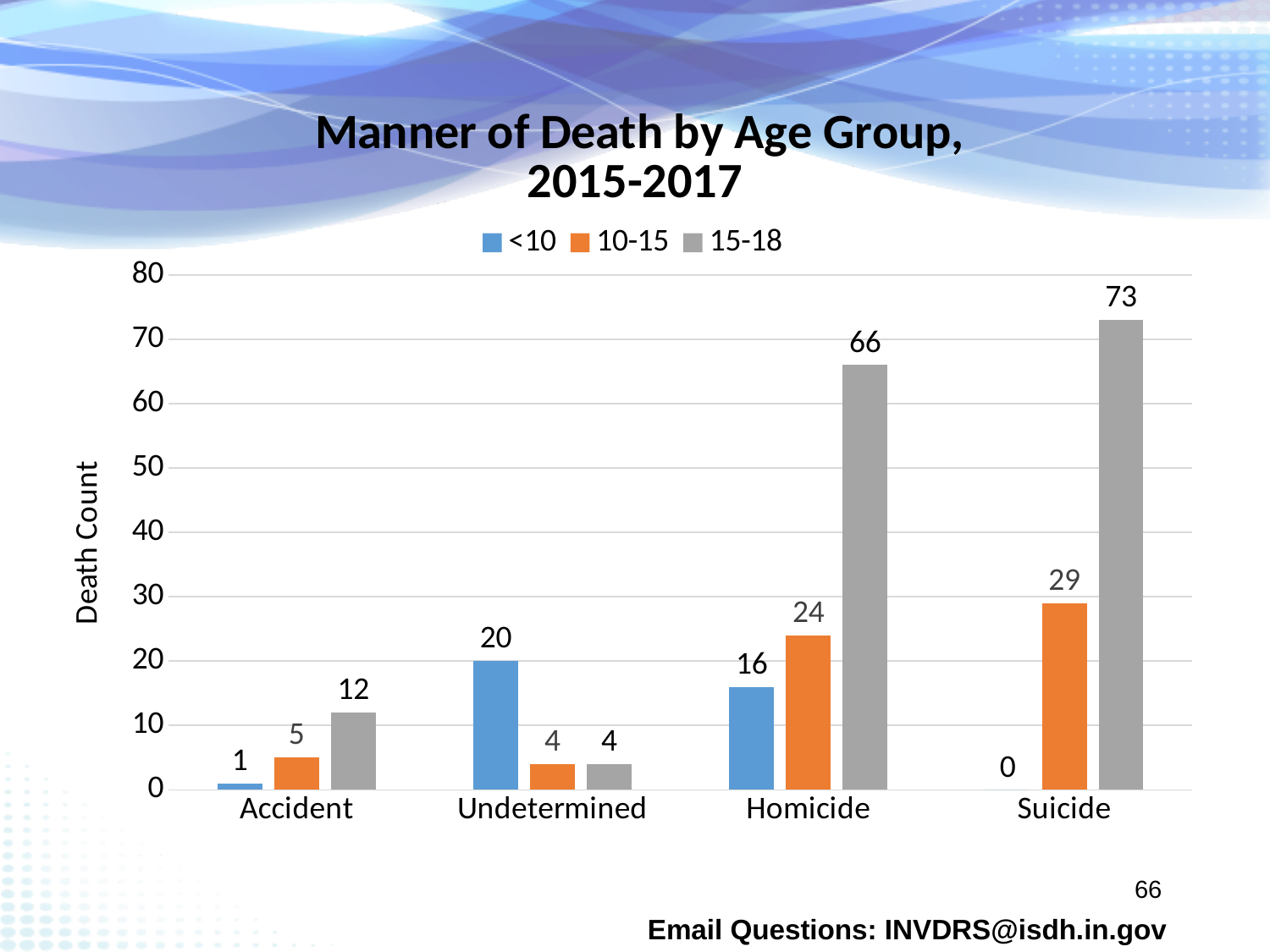
Which manner of death has the lowest death count for the <10 age group? Suicide What is the death count for the <10 age group for Undetermined? 20 What kind of chart is shown on the slide? Bar chart Is the 15-18 death count for Homicide greater or less than 60? greater What is the difference between the 15-18 death counts for Suicide and Homicide? 7 Which is larger, the 10-15 death count for Accident or the 10-15 death count for Undetermined? Accident How many manner-of-death categories are shown on the x axis? 4 What is the death count for the 10-15 age group for Homicide? 24 Which manner of death has the highest death count for the 15-18 age group? Suicide What is the death count for the 15-18 age group for Suicide? 73 What is the label of the y axis? Death Count How many age groups does the legend list? 3